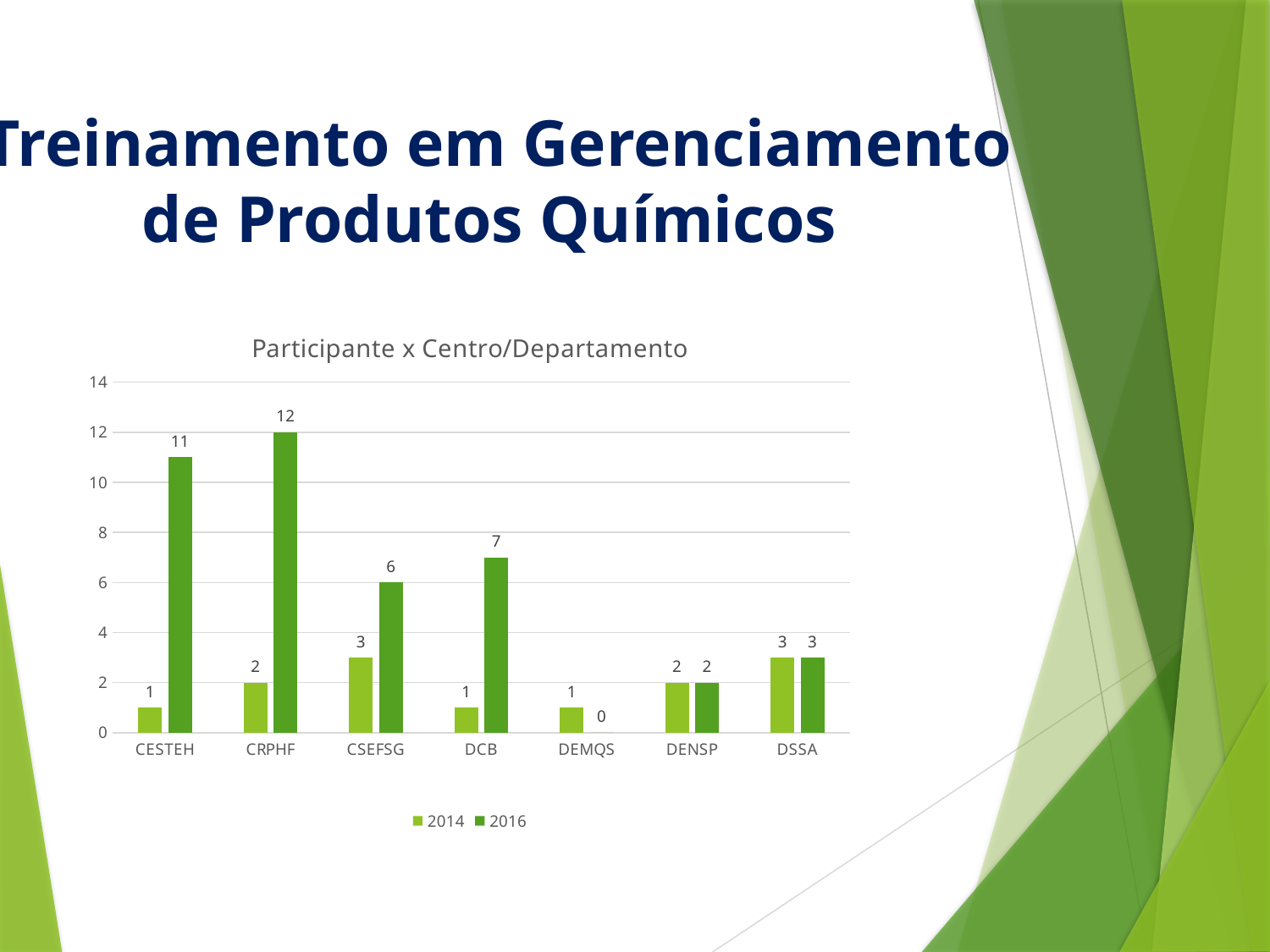
Which category has the lowest value in the 2016 series? DEMQS What is the value for CESTEH in the 2014 series? 1 How many series does the legend list? 2 What kind of chart is shown on the slide? Bar chart What is the value for DEMQS in the 2016 series? 0 How many categories are shown on the x axis? 7 What is the difference between the 2016 values for CRPHF and CSEFSG? 6 Which category has the highest value in the 2016 series? CRPHF What is the difference between the 2016 and 2014 values for CESTEH? 10 What is the title of the chart? Participante x Centro/Departamento What is the value for CRPHF in the 2016 series? 12 Which is larger for DCB: the 2014 value or the 2016 value? 2016